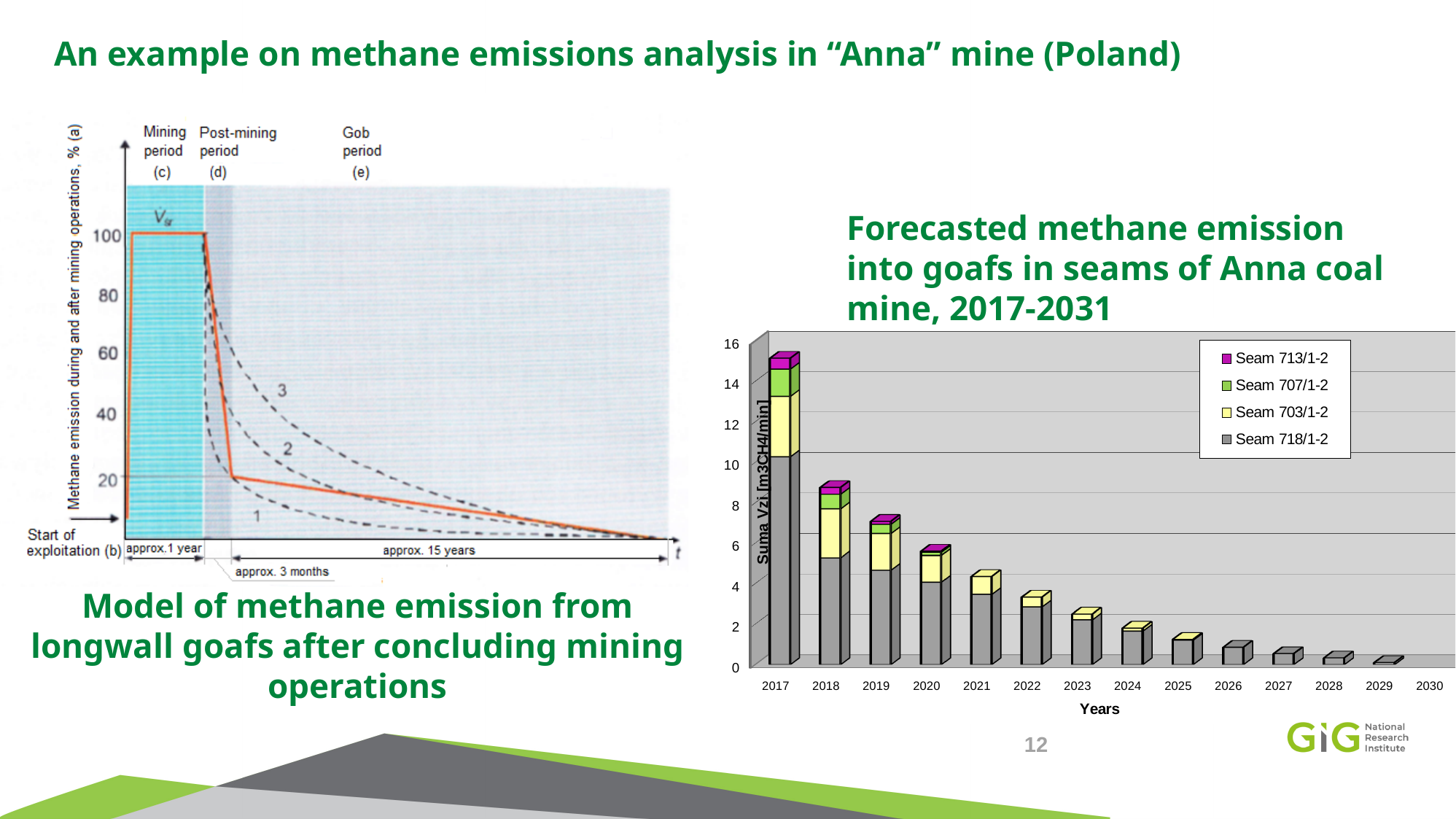
In the 'Forecasted methane emission' chart, is the total value for 2025 greater or less than 2? less In the 'Model of methane emission from longwall goafs' chart on the left, does the red line rise or fall during the gob period? fall In the 'Model of methane emission from longwall goafs' chart on the left, what is the peak value reached by the red line during the mining period? 100 How many series does the legend of the 'Forecasted methane emission' chart list? 4 What kind of chart is the 'Forecasted methane emission into goafs in seams of Anna coal mine, 2017-2031' chart? Stacked bar chart In the 'Forecasted methane emission' chart, do the total emissions rise or fall from 2017 to 2030? fall In the 'Forecasted methane emission' chart, is the total value for 2017 greater or less than 14? greater In the 'Forecasted methane emission' chart, which is larger, the total for 2019 or the total for 2022? 2019 In the 'Forecasted methane emission' chart, which seam is shown in magenta in the legend? Seam 713/1-2 In the 'Forecasted methane emission' chart, is the total value for 2018 greater or less than 8? greater In the 'Forecasted methane emission' chart, which year has the highest total emission? 2017 What is the x-axis title of the 'Forecasted methane emission' chart? Years